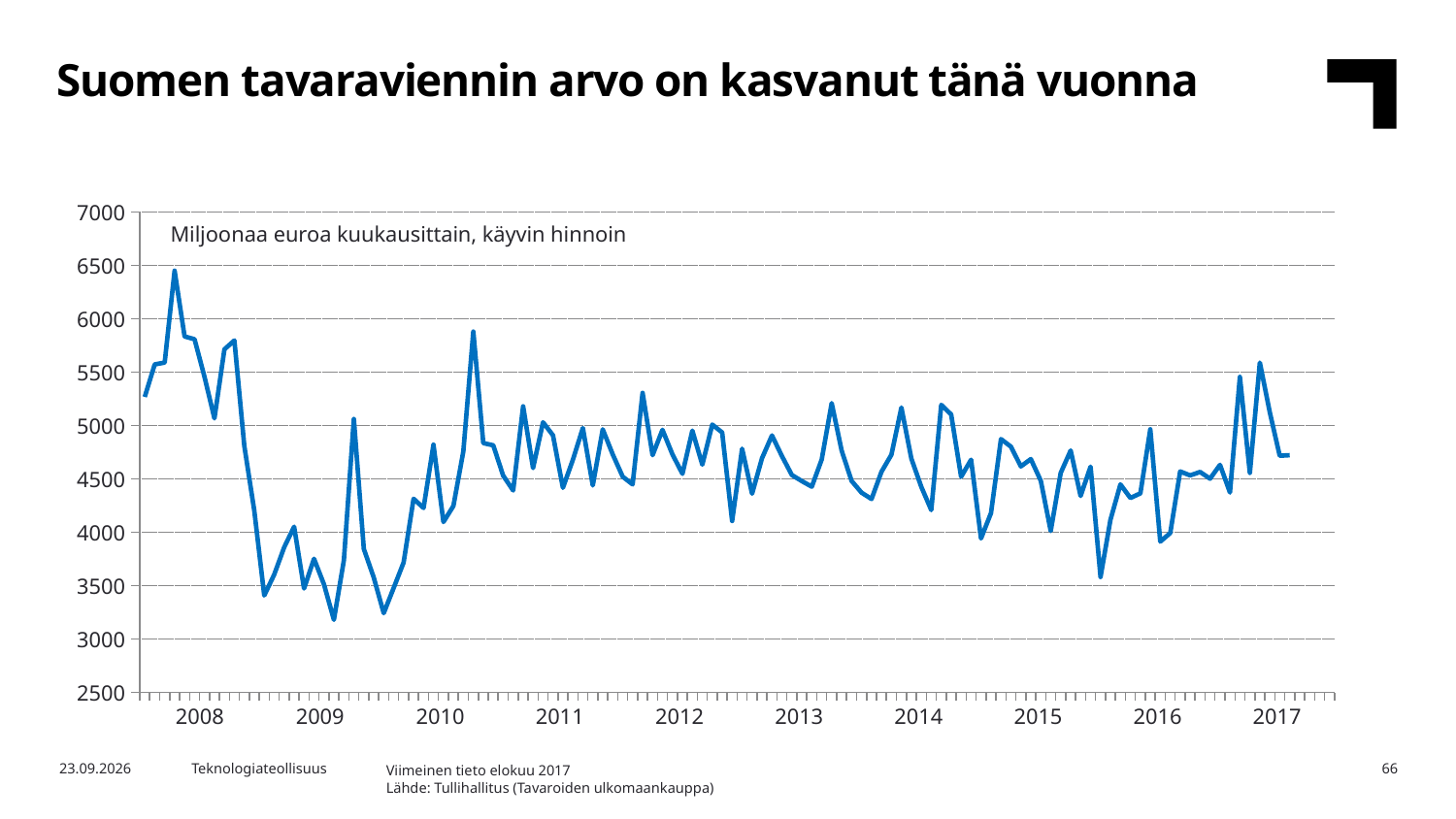
Is the peak value in 2010 greater or less than 5500? greater Do the values rise or fall from early 2008 to early 2009? fall How many year labels are shown on the x axis? 10 Is the highest value in 2008 greater or less than 6000? greater What kind of chart is shown on the slide? line chart Is the lowest value in 2009 greater or less than 3500? less What unit description is printed inside the chart area? Miljoonaa euroa kuukausittain, käyvin hinnoin What is the title of the slide's chart? Suomen tavaraviennin arvo on kasvanut tänä vuonna In which year does the line reach its highest point? 2008 Which is higher, the peak in 2008 or the peak in 2010? the peak in 2008 In which year does the line reach its lowest point? 2009